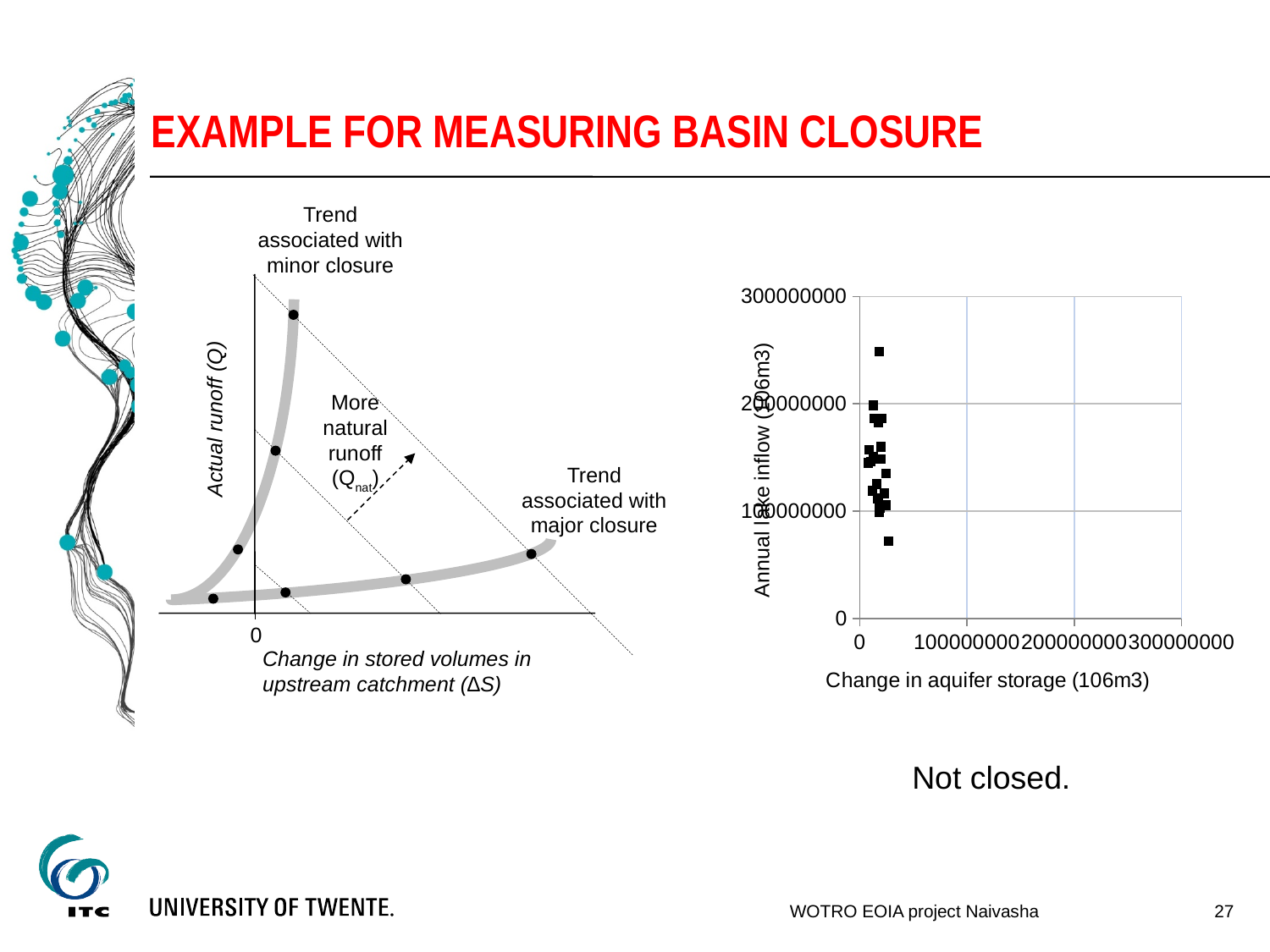
On the right-hand scatter chart, is the highest plotted annual lake inflow value greater or less than 300000000? less What is the x-axis title of the scatter chart on the right of the slide? Change in aquifer storage (106m3) On the right-hand scatter chart, are the plotted change in aquifer storage values greater or less than 100000000? less On the right-hand scatter chart, what is the maximum value shown on the y axis? 300000000 On the right-hand scatter chart, is the highest plotted annual lake inflow value greater or less than 200000000? greater What kind of chart is the chart on the right of the slide? scatter chart What is the y-axis title of the scatter chart on the right of the slide? Annual lake inflow (106m3)